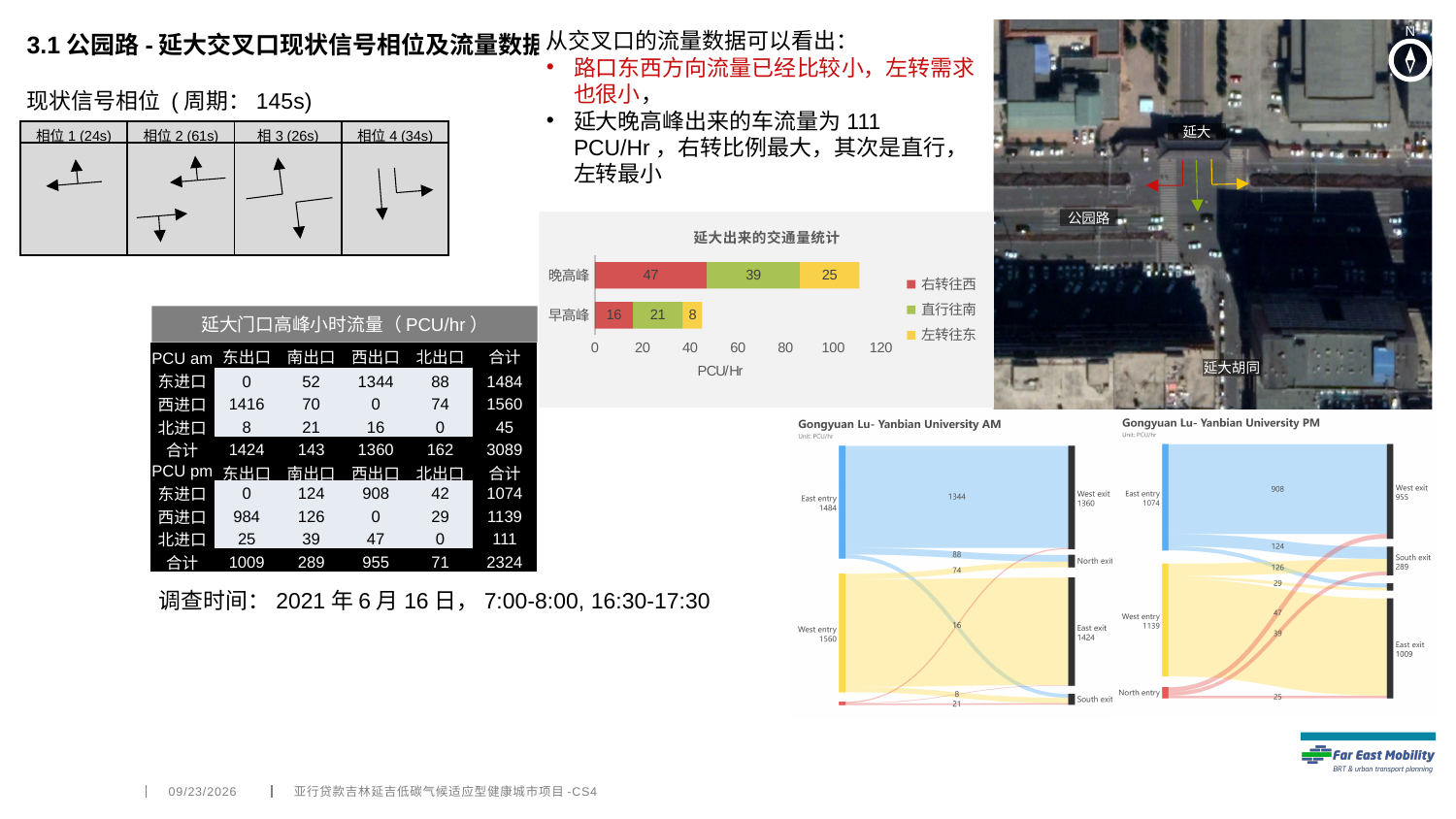
In the chart titled 延大出来的交通量统计, what is the total of the stacked bar for 早高峰? 45 In the chart titled 延大出来的交通量统计, which series has the highest value for 晚高峰? 右转往西 In the chart titled 延大出来的交通量统计, what is the value of 直行往南 for 早高峰? 21 In the chart titled 延大出来的交通量统计, what is the value of 右转往西 for 晚高峰? 47 What kind of chart is the chart titled 延大出来的交通量统计? Stacked bar chart In the chart titled 延大出来的交通量统计, what is the difference between the 右转往西 values for 晚高峰 and 早高峰? 31 In the chart titled 延大出来的交通量统计, what is the total of the stacked bar for 晚高峰? 111 In the chart titled 延大出来的交通量统计, which is larger for 晚高峰: 直行往南 or 左转往东? 直行往南 How many series does the legend of the chart titled 延大出来的交通量统计 list? 3 In the Sankey diagram titled Gongyuan Lu- Yanbian University AM, what is the flow value from East entry to West exit? 1344 How many categories are shown on the vertical axis of the chart titled 延大出来的交通量统计? 2 In the chart titled 延大出来的交通量统计, what is the value of 左转往东 for 晚高峰? 25